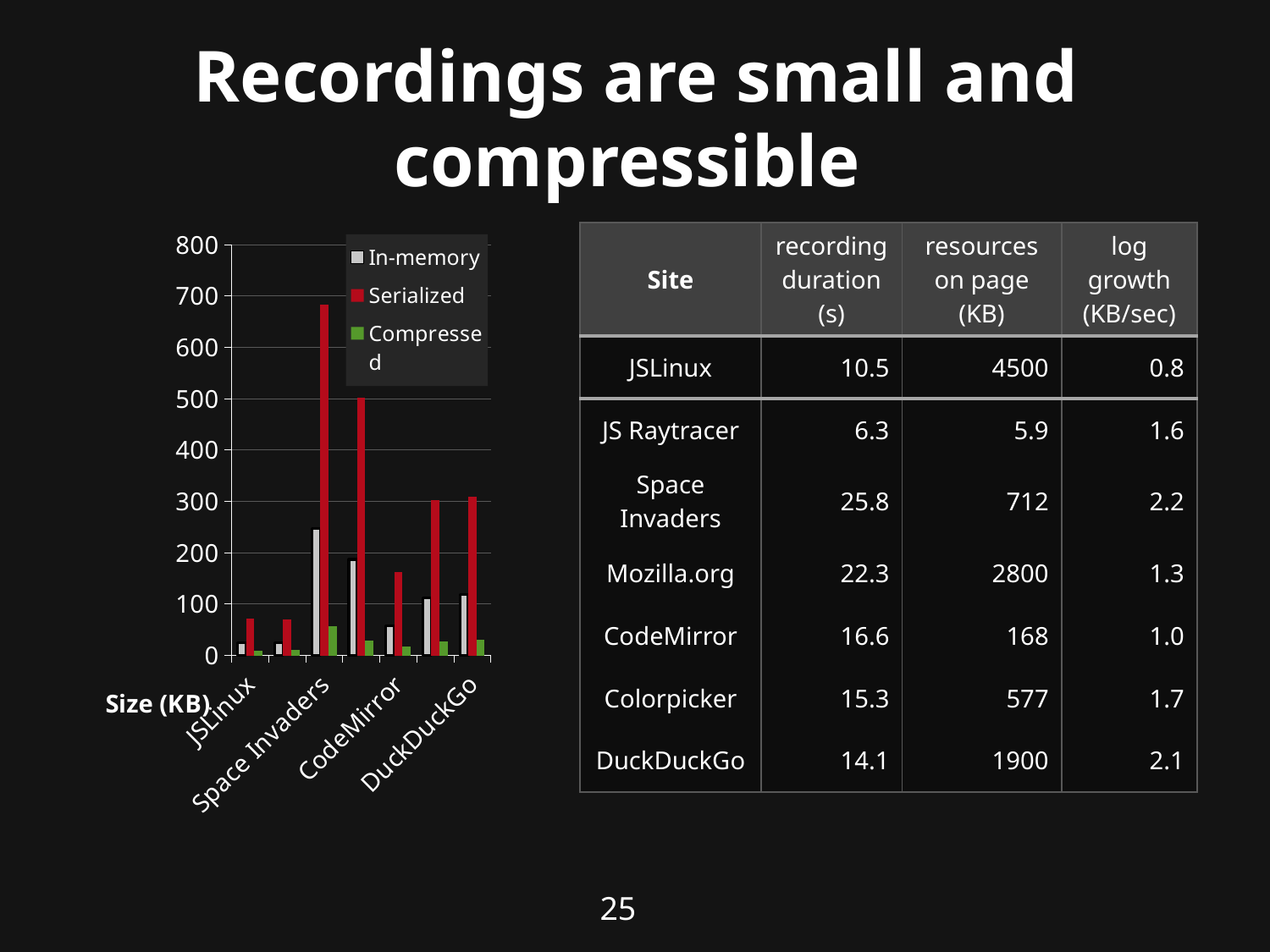
How many groups of bars (sites) are plotted in the chart? 7 Is the Compressed value for CodeMirror greater or less than 100? less Which site has the highest Serialized value in the chart? Space Invaders Is the Serialized value for Space Invaders greater or less than 600? greater What kind of chart is shown on the slide? bar chart Which has the larger Serialized value, Space Invaders or CodeMirror? Space Invaders Is the Serialized value for JSLinux greater or less than 100? less What are the three series named in the chart's legend? In-memory, Serialized, Compressed What colour are the Serialized bars in the chart? red How many series does the chart's legend list? 3